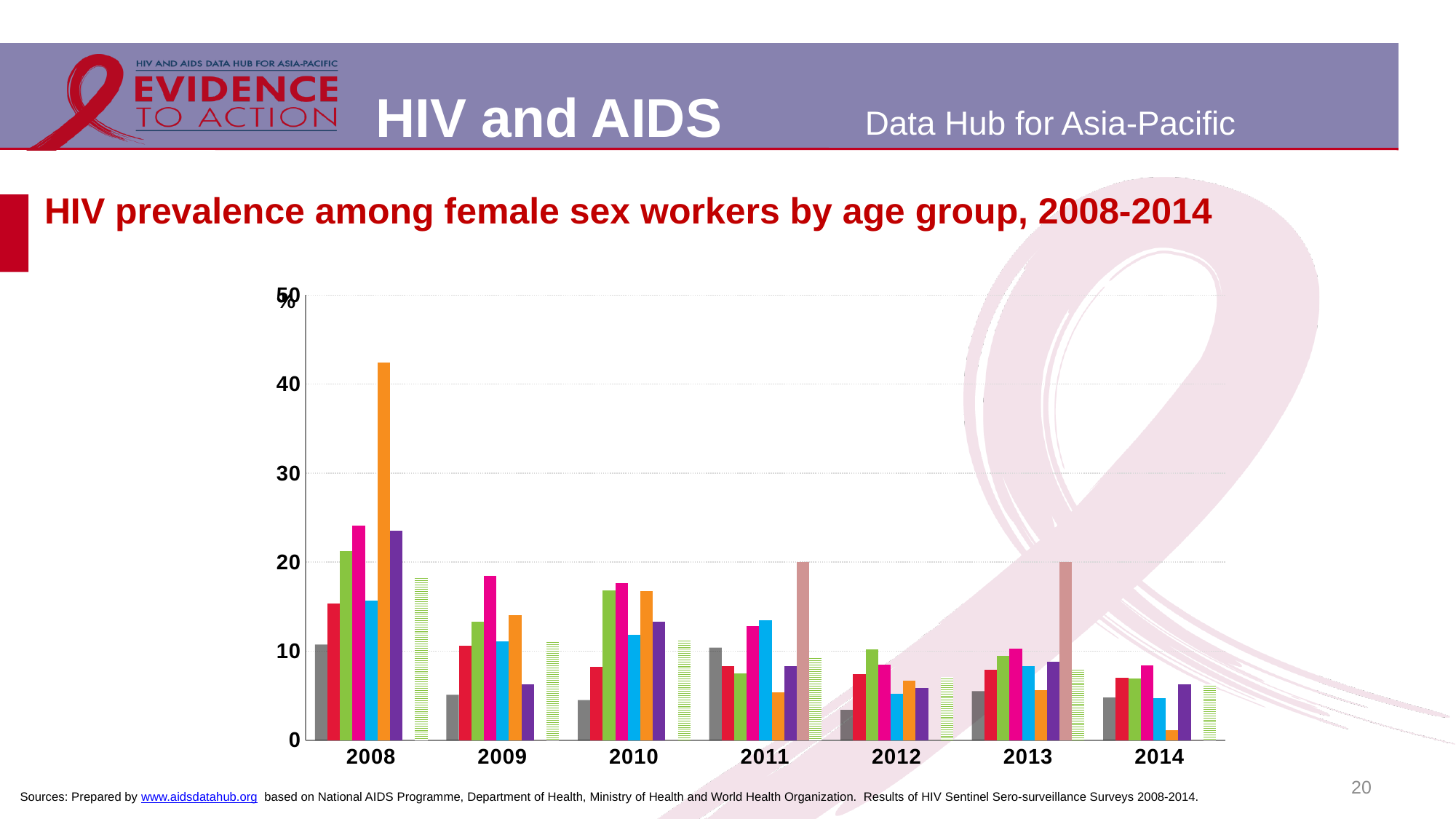
What is the highest value shown on the y axis of the chart? 50 What is the title of the chart on the slide? HIV prevalence among female sex workers by age group, 2008-2014 Is the tallest bar in 2009 greater or less than 20? less Is the tallest bar in 2008 greater or less than 40? greater How many years are shown along the x axis of the chart? 7 What kind of chart is shown on the slide? bar chart In which year does the tallest bar in the chart appear? 2008 Is the tallest bar in 2014 greater or less than 10? less Which year is the first year shown on the x axis? 2008